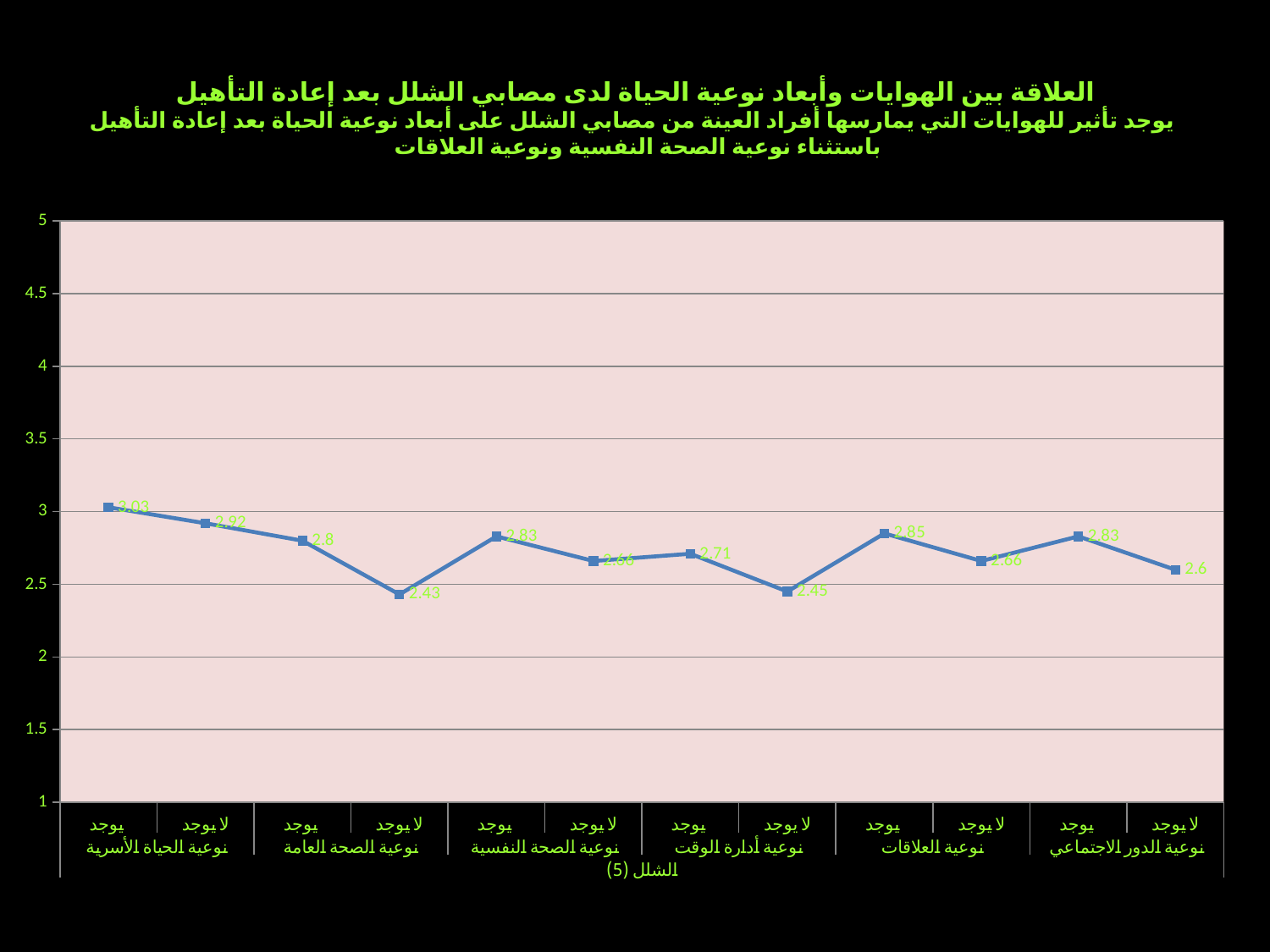
What is the value for "لا يوجد" under "نوعية الصحة العامة"? 2.43 What is the value for "لا يوجد" under "نوعية الدور الاجتماعي"? 2.6 What is the difference between "يوجد" and "لا يوجد" under "نوعية الصحة العامة"? 0.37 What is the value for "يوجد" under "نوعية العلاقات"? 2.85 What is the label shown below the x axis? الشلل (5) Which data point has the lowest value? لا يوجد – نوعية الصحة العامة (2.43) Is the value for "لا يوجد" under "نوعية الحياة الأسرية" greater or less than 2.5? greater Which is larger: "يوجد" under "نوعية إدارة الوقت" or "لا يوجد" under "نوعية إدارة الوقت"? يوجد (2.71) What type of chart is shown on the slide? Line chart How many data points are plotted on the line? 12 Which data point has the highest value? يوجد – نوعية الحياة الأسرية (3.03) What is the value for "يوجد" under "نوعية الحياة الأسرية"? 3.03